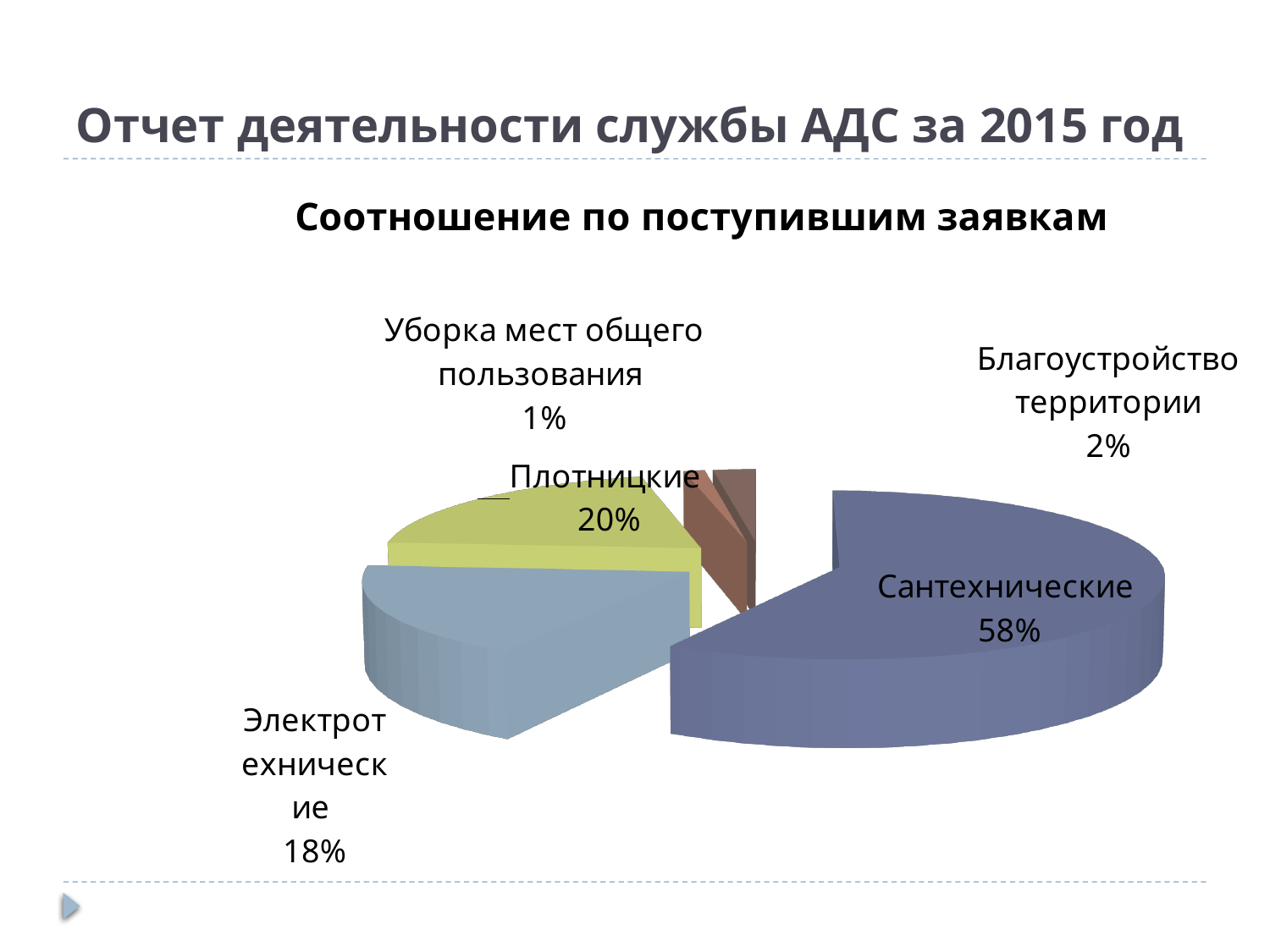
Which category has the smallest share of the pie? Уборка мест общего пользования How many categories does the pie chart show? 5 Which is larger, the share for Плотницкие or the share for Электротехнические? Плотницкие Which category has the largest share of the pie? Сантехнические What share of the pie is Сантехнические? 58% What is the chart's title? Соотношение по поступившим заявкам What share of the pie is Благоустройство территории? 2% What share of the pie is Электротехнические? 18% What kind of chart is shown on the slide? Pie chart What share of the pie is Плотницкие? 20% What is the difference in percentage points between Сантехнические and Плотницкие? 38 What share of the pie is Уборка мест общего пользования? 1%